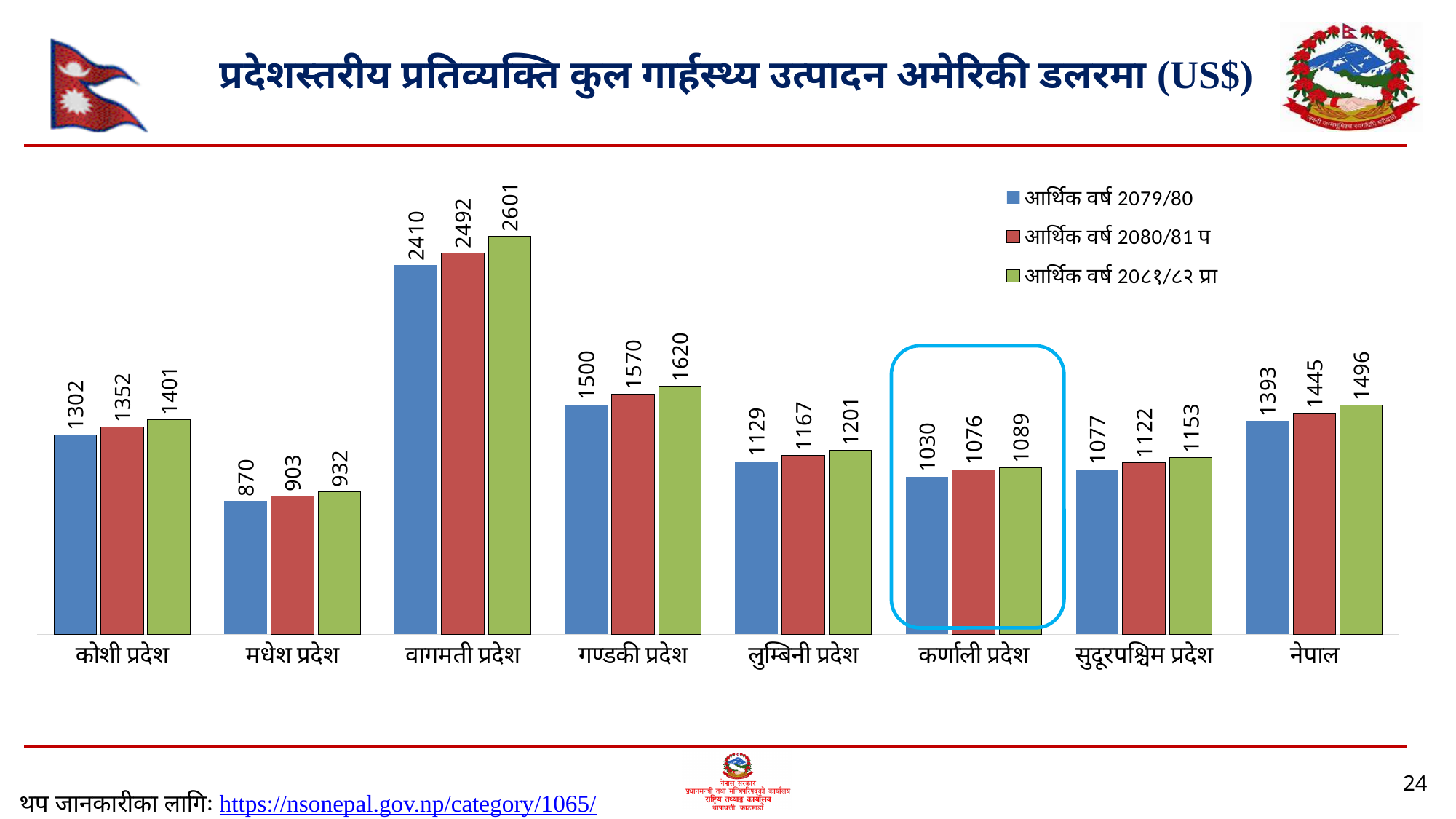
Which category has the highest value in the आर्थिक वर्ष 2079/80 series? वागमती प्रदेश How many series does the legend list? 3 What kind of chart is shown on the slide? Bar chart Which category is highlighted with a blue rounded box on the chart? कर्णाली प्रदेश What is the value for मधेश प्रदेश in the आर्थिक वर्ष 2079/80 series? 870 Which is larger in the आर्थिक वर्ष 2080/81 प series: कर्णाली प्रदेश or सुदूरपश्चिम प्रदेश? सुदूरपश्चिम प्रदेश What is the value for वागमती प्रदेश in the आर्थिक वर्ष २०८१/८२ प्रा series? 2601 What is the value for नेपाल in the आर्थिक वर्ष 2080/81 प series? 1445 For लुम्बिनी प्रदेश, do the values rise or fall from आर्थिक वर्ष 2079/80 to आर्थिक वर्ष २०८१/८२ प्रा? Rise What is the difference between the आर्थिक वर्ष २०८१/८२ प्रा value and the आर्थिक वर्ष 2079/80 value for गण्डकी प्रदेश? 120 Which category has the lowest value in the आर्थिक वर्ष २०८१/८२ प्रा series? मधेश प्रदेश How many categories are shown on the x axis? 8